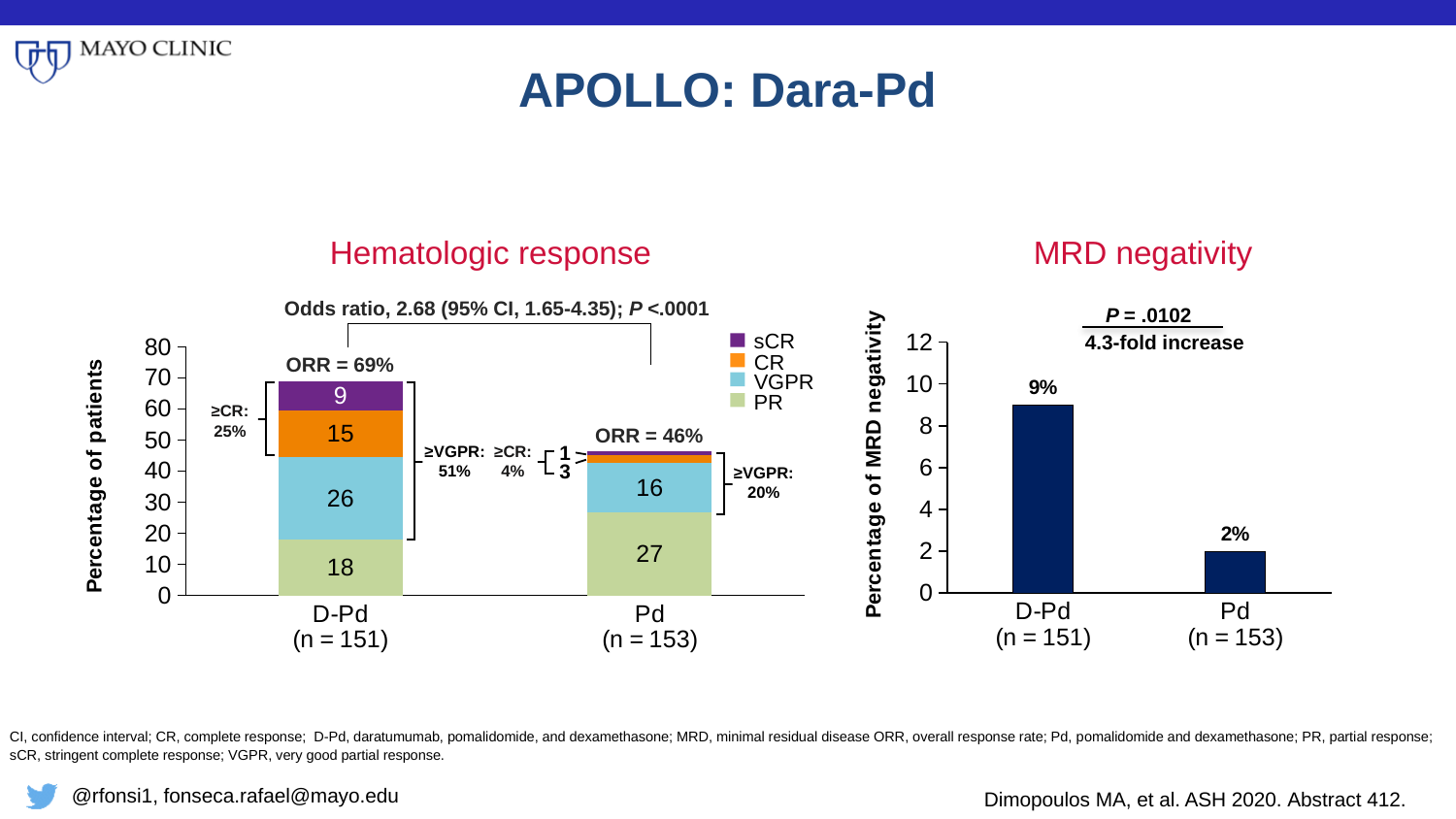
In the Hematologic response chart, what is the VGPR value for Pd? 16 In the Hematologic response chart, what is the sCR value for D-Pd? 9 In the Hematologic response chart, what is the difference between the VGPR values for D-Pd and Pd? 10 In the MRD negativity chart, what is the difference between the D-Pd and Pd values? 7% What kind of chart is the MRD negativity chart? Bar chart In the Hematologic response chart, which group has the larger CR value, D-Pd or Pd? D-Pd In the Hematologic response chart, what is the PR value for D-Pd? 18 In the MRD negativity chart, what is the value for D-Pd? 9% In the MRD negativity chart, which group has the lowest MRD negativity? Pd How many series does the legend of the Hematologic response chart list? 4 In the Hematologic response chart, what is the ORR for Pd? 46%